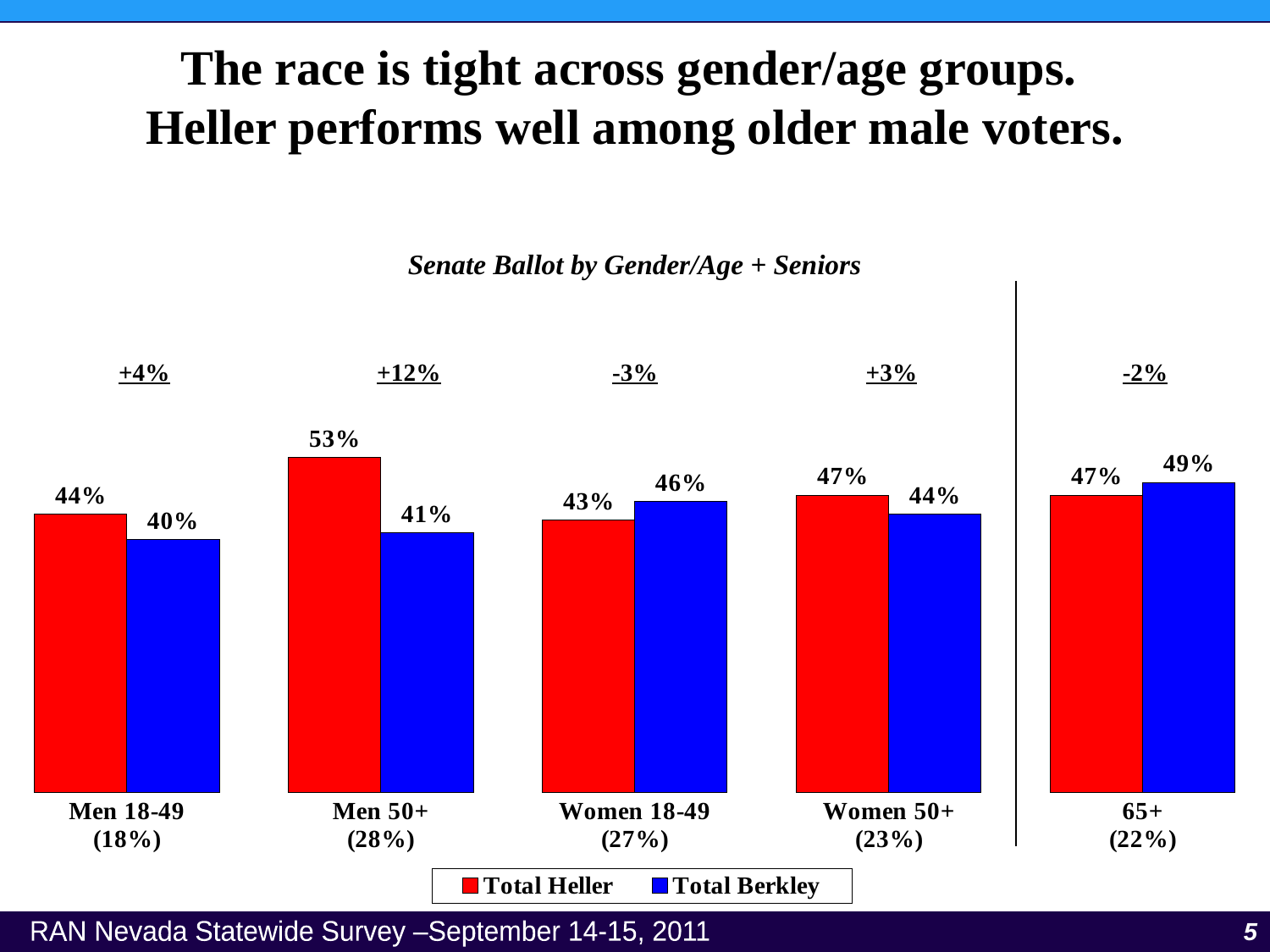
What is the difference between Total Heller and Total Berkley for Men 50+? 12% How many series does the legend list? 2 Which category has the lowest Total Berkley value? Men 18-49 What is the Total Berkley value for 65+? 49% What is the Total Heller value for Men 50+? 53% Which category has the highest Total Heller value? Men 50+ What is the Total Berkley value for Women 18-49? 46% For Women 18-49, which is larger: Total Heller or Total Berkley? Total Berkley How many gender/age categories are shown on the x axis? 5 Which colour represents Total Berkley in the chart? Blue What kind of chart is shown on the slide? Bar chart What is the title of the chart? Senate Ballot by Gender/Age + Seniors